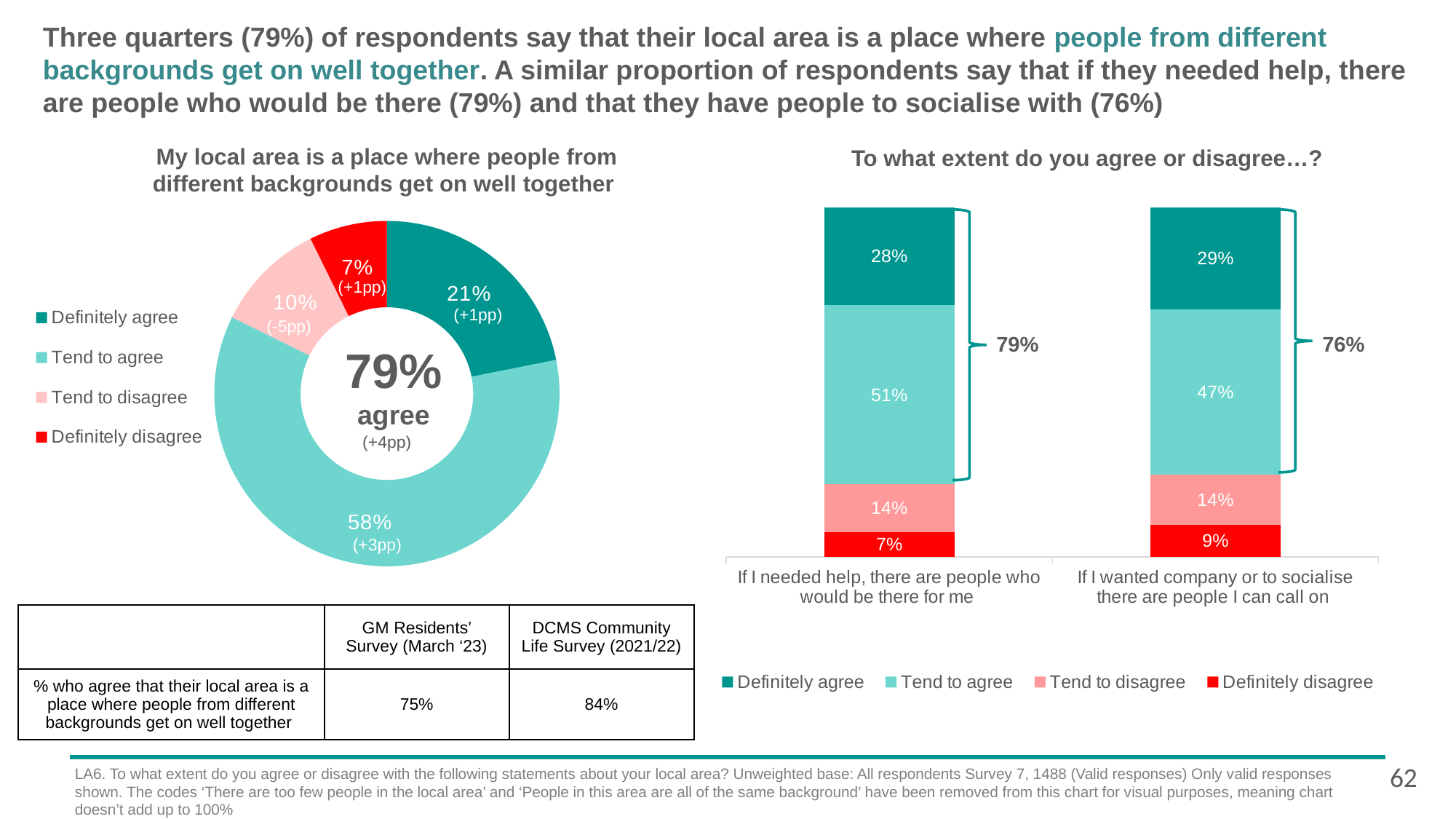
In the stacked bar chart on the right, which statement has the higher 'Definitely disagree' percentage? If I wanted company or to socialise there are people I can call on In the donut chart on the left, which response category has the smallest share? Definitely disagree In the donut chart on the left, what is the difference between the 'Tend to agree' and 'Definitely agree' shares? 37 percentage points In the stacked bar chart on the right, what percentage 'Tend to agree' that if they needed help, there are people who would be there for them? 51% How many statements (bars) are shown in the stacked bar chart on the right? 2 What kind of chart is used on the right-hand side of the slide, 'To what extent do you agree or disagree…?' Stacked bar chart In the donut chart on the left, what percentage of respondents 'Definitely disagree'? 7% In the donut chart on the left, which response category has the largest share? Tend to agree In the donut chart 'My local area is a place where people from different backgrounds get on well together', what percentage of respondents 'Tend to agree'? 58% In the stacked bar chart on the right, what is the total agreement shown for 'If I wanted company or to socialise there are people I can call on'? 76% How many series does the legend of the stacked bar chart on the right list? 4 In the stacked bar chart on the right, what percentage 'Definitely agree' that if they wanted company or to socialise there are people they can call on? 29%